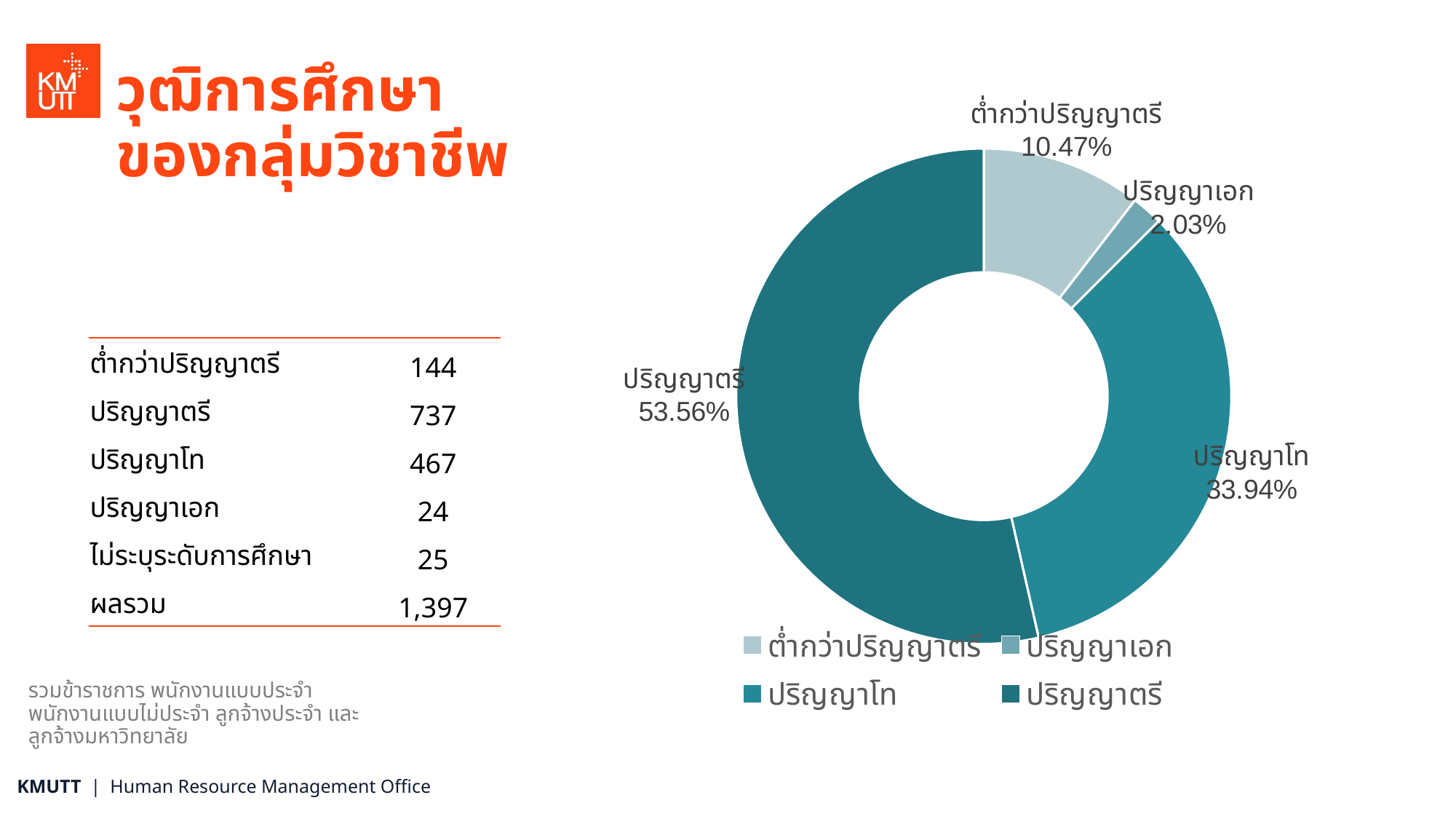
What is the title of the slide containing the chart? วุฒิการศึกษาของกลุ่มวิชาชีพ Which is larger, the share for ปริญญาโท or the share for ต่ำกว่าปริญญาตรี? ปริญญาโท What percentage is shown for ต่ำกว่าปริญญาตรี? 10.47% What percentage is shown for ปริญญาเอก? 2.03% What share of the pie does ปริญญาตรี hold? 53.56% Which category has the largest slice of the pie? ปริญญาตรี How many slices does the pie chart have? 4 What percentage is shown for ปริญญาโท? 33.94% How many entries does the legend list? 4 What is the difference in percentage points between ปริญญาตรี and ปริญญาโท? 19.62 Which category has the smallest slice of the pie? ปริญญาเอก What kind of chart is shown on the slide? Pie chart (donut)